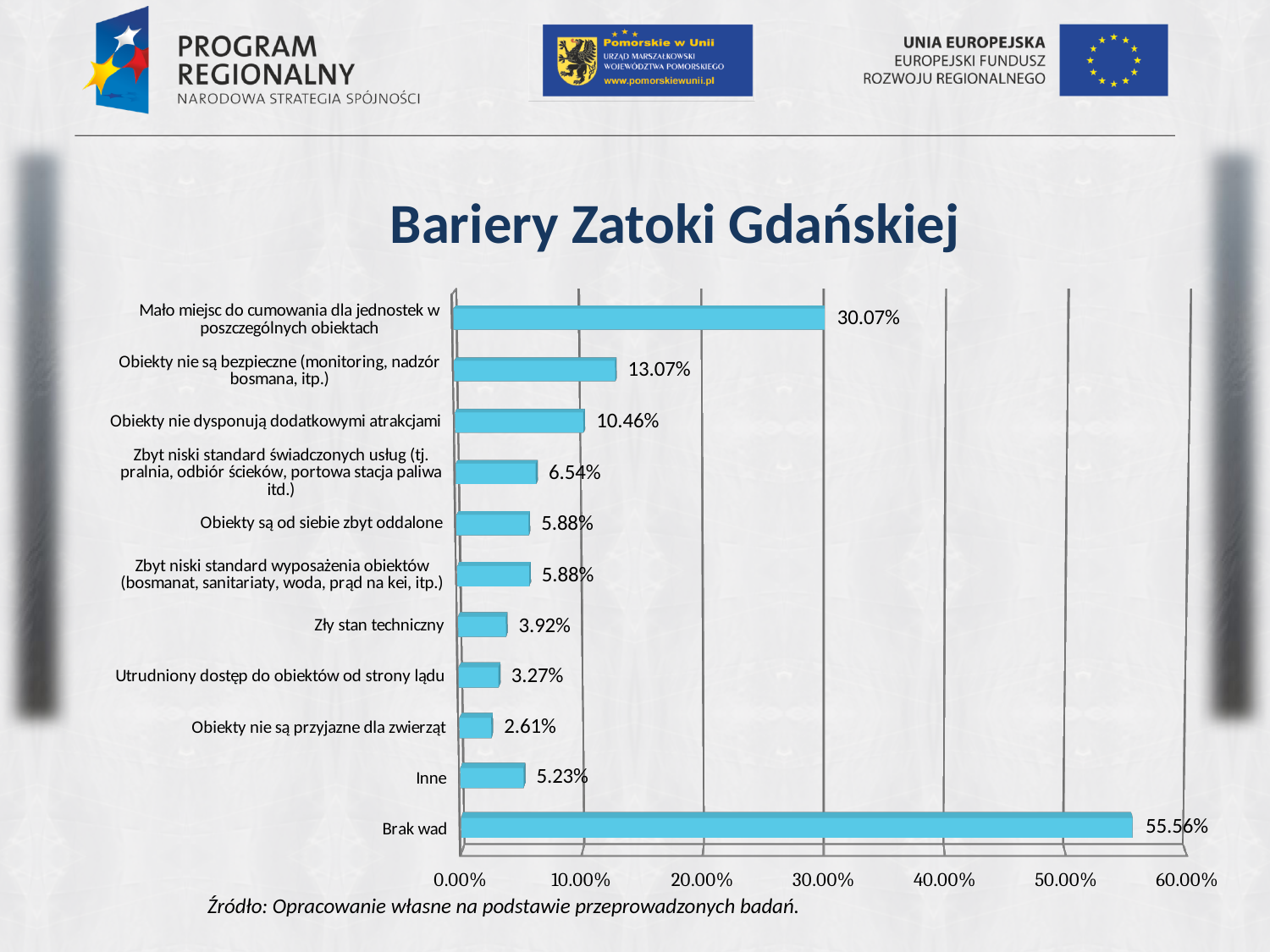
Which category has the lowest value? Obiekty nie są przyjazne dla zwierząt What is the title of the chart? Bariery Zatoki Gdańskiej What is the value for "Inne"? 5.23% What is the value for "Mało miejsc do cumowania dla jednostek w poszczególnych obiektach"? 30.07% Which category has the highest value? Brak wad How many categories are shown in the chart? 11 Is the value for "Brak wad" greater or less than 50.00%? greater What type of chart is shown on the slide? Bar chart Which is larger: the value for "Obiekty nie są bezpieczne (monitoring, nadzór bosmana, itp.)" or for "Obiekty nie dysponują dodatkowymi atrakcjami"? Obiekty nie są bezpieczne (monitoring, nadzór bosmana, itp.) What is the value for "Zły stan techniczny"? 3.92% What is the value for "Brak wad"? 55.56% What is the difference between the values for "Brak wad" and "Mało miejsc do cumowania dla jednostek w poszczególnych obiektach"? 25.49%